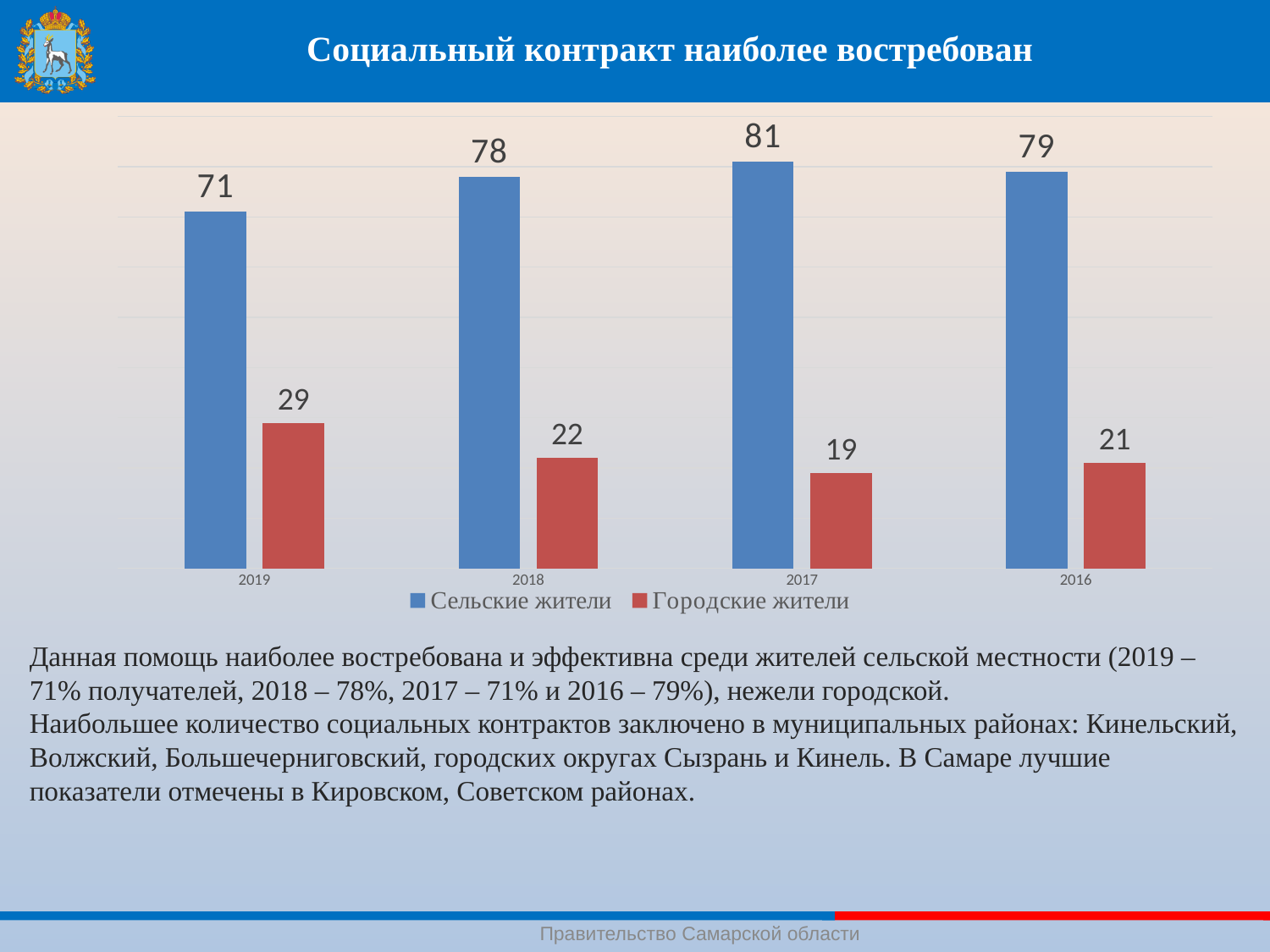
What is the value for Городские жители in 2016? 21 How many years are shown on the x axis? 4 What is the value for Городские жители in 2017? 19 What colour are the bars for Городские жители? Red What is the difference between Сельские жители and Городские жители in 2018? 56 Which is larger in 2019: Сельские жители or Городские жители? Сельские жители In which year is the value for Сельские жители highest? 2017 What is the total of Сельские жители and Городские жители in 2019? 100 What is the value for Сельские жители in 2019? 71 In which year is the value for Городские жители lowest? 2017 What kind of chart is shown on the slide? Bar chart How many series does the legend list? 2